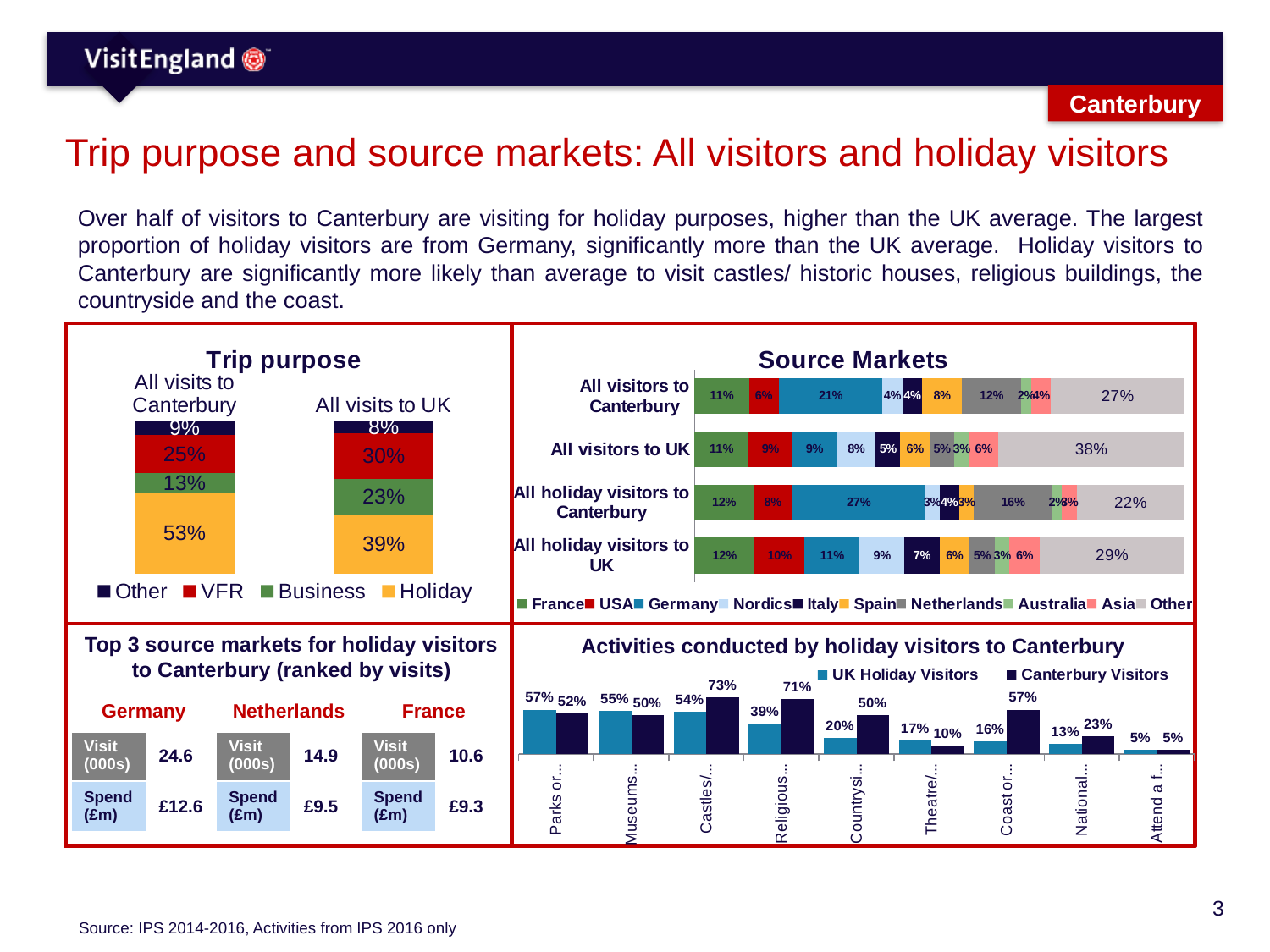
In the Source Markets chart, what is the Germany share for All holiday visitors to Canterbury? 27% In the Trip purpose chart, what percentage of all visits to Canterbury are for Holiday? 53% In the Activities conducted by holiday visitors to Canterbury chart, what is the Canterbury Visitors value for the Castles/ category? 73% In the Trip purpose chart, what is the difference between the Holiday share for All visits to Canterbury and for All visits to UK? 14 percentage points In the Activities conducted by holiday visitors to Canterbury chart, what is the difference between Canterbury Visitors and UK Holiday Visitors for the Coast or category? 41 percentage points How many activity categories are shown in the Activities conducted by holiday visitors to Canterbury chart? 9 In the Trip purpose chart, which trip purpose has the smallest share for All visits to Canterbury? Other In the Source Markets chart, is the Netherlands share larger for All holiday visitors to Canterbury or for All holiday visitors to UK? All holiday visitors to Canterbury How many series does the legend of the Source Markets chart list? 10 What type of chart is the Activities conducted by holiday visitors to Canterbury chart? Bar chart In the Trip purpose chart, what is the VFR share for All visits to UK? 30% In the Source Markets chart, what is the Other share for All visitors to UK? 38%